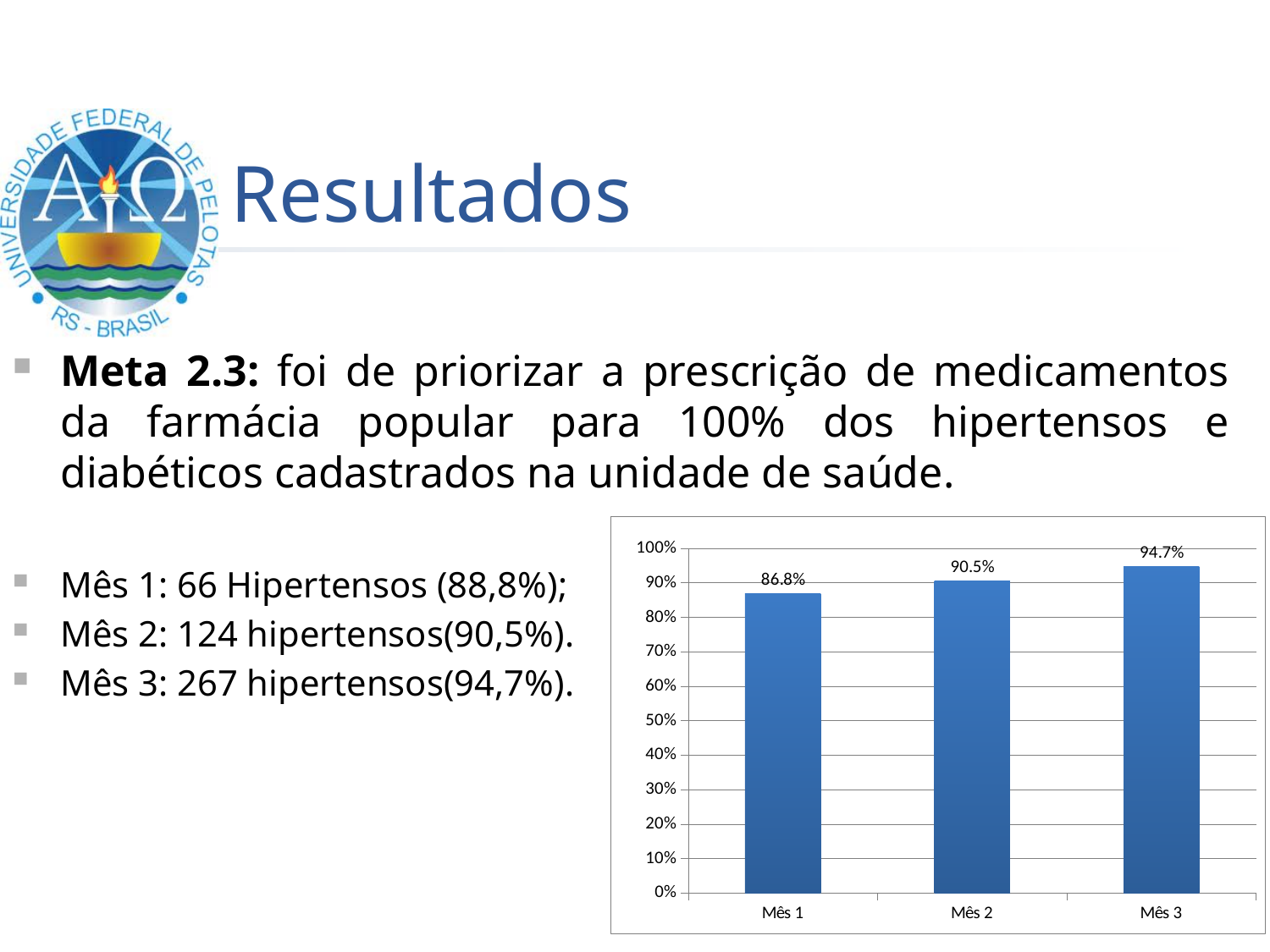
What is the difference between the values for Mês 3 and Mês 1? 7.9 percentage points How many categories are shown on the x axis of the chart? 3 What is the difference between the values for Mês 2 and Mês 1? 3.7 percentage points What is the value shown for Mês 2 in the chart? 90.5% What kind of chart is shown on the slide? bar chart Do the values rise or fall from Mês 1 to Mês 3? rise Which is larger, the value for Mês 2 or the value for Mês 3? Mês 3 What is the value shown for Mês 3 in the chart? 94.7% Which month has the lowest value in the chart? Mês 1 What is the value shown for Mês 1 in the chart? 86.8% Is the value for Mês 1 greater or less than 90%? less Which month has the highest value in the chart? Mês 3